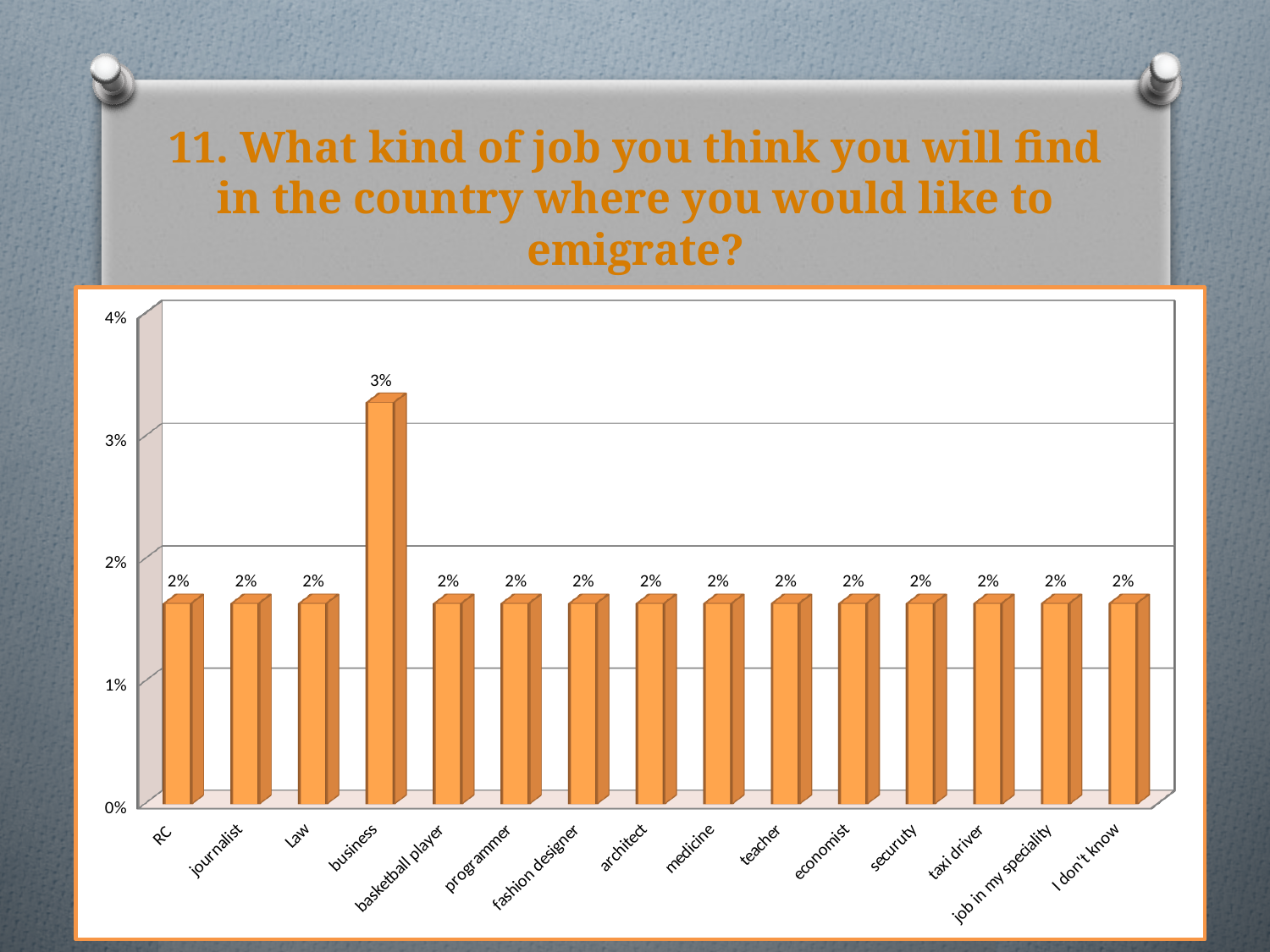
What is the value for 'I don't know'? 2% What is the value for business? 3% Which is larger, the value for business or the value for architect? business Is the value for medicine greater or less than 3%? less What is the difference between the values for business and teacher? 1% Which category has the highest value? business What is the highest value shown on the vertical axis? 4% How many categories are shown on the x axis? 15 Is the value for business greater or less than 2%? greater What is the value for fashion designer? 2% What is the value for taxi driver? 2% What kind of chart is shown on the slide? bar chart